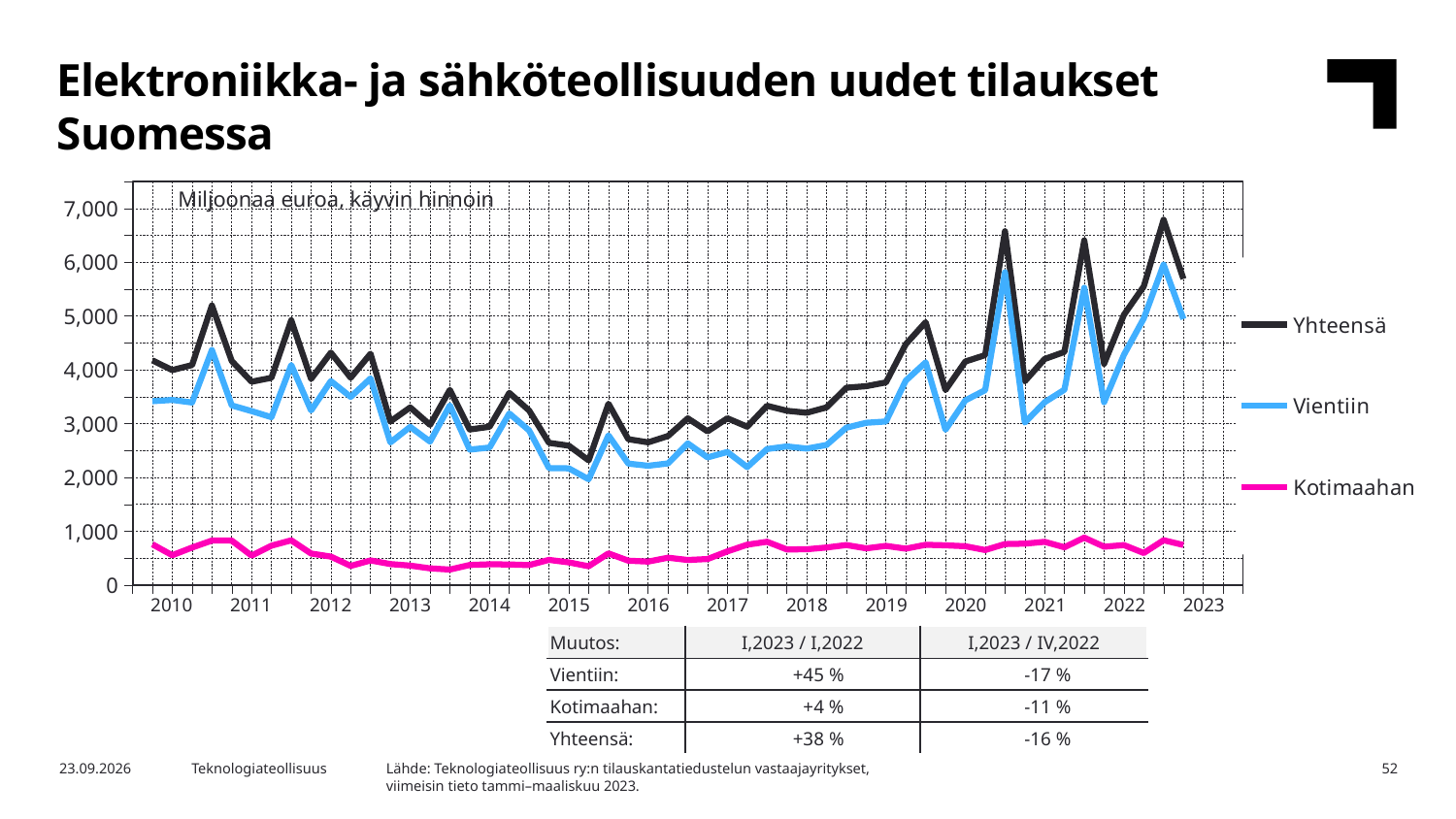
Is the highest value of Yhteensä in 2020 greater or less than 6,000? greater What is the title of the slide containing the chart? Elektroniikka- ja sähköteollisuuden uudet tilaukset Suomessa What kind of chart is shown on the slide? Line chart Is the value for Vientiin at the start of 2010 greater or less than 3,000? greater Which series has the lowest values throughout the chart? Kotimaahan Is the value for Kotimaahan at the start of 2010 greater or less than 1,000? less How many series does the legend list? 3 What are the three series named in the legend? Yhteensä, Vientiin, Kotimaahan In 2023, which is larger: Vientiin or Kotimaahan? Vientiin Which series has the highest values throughout the chart? Yhteensä Does the Yhteensä line overall rise or fall between 2015 and 2022? rise